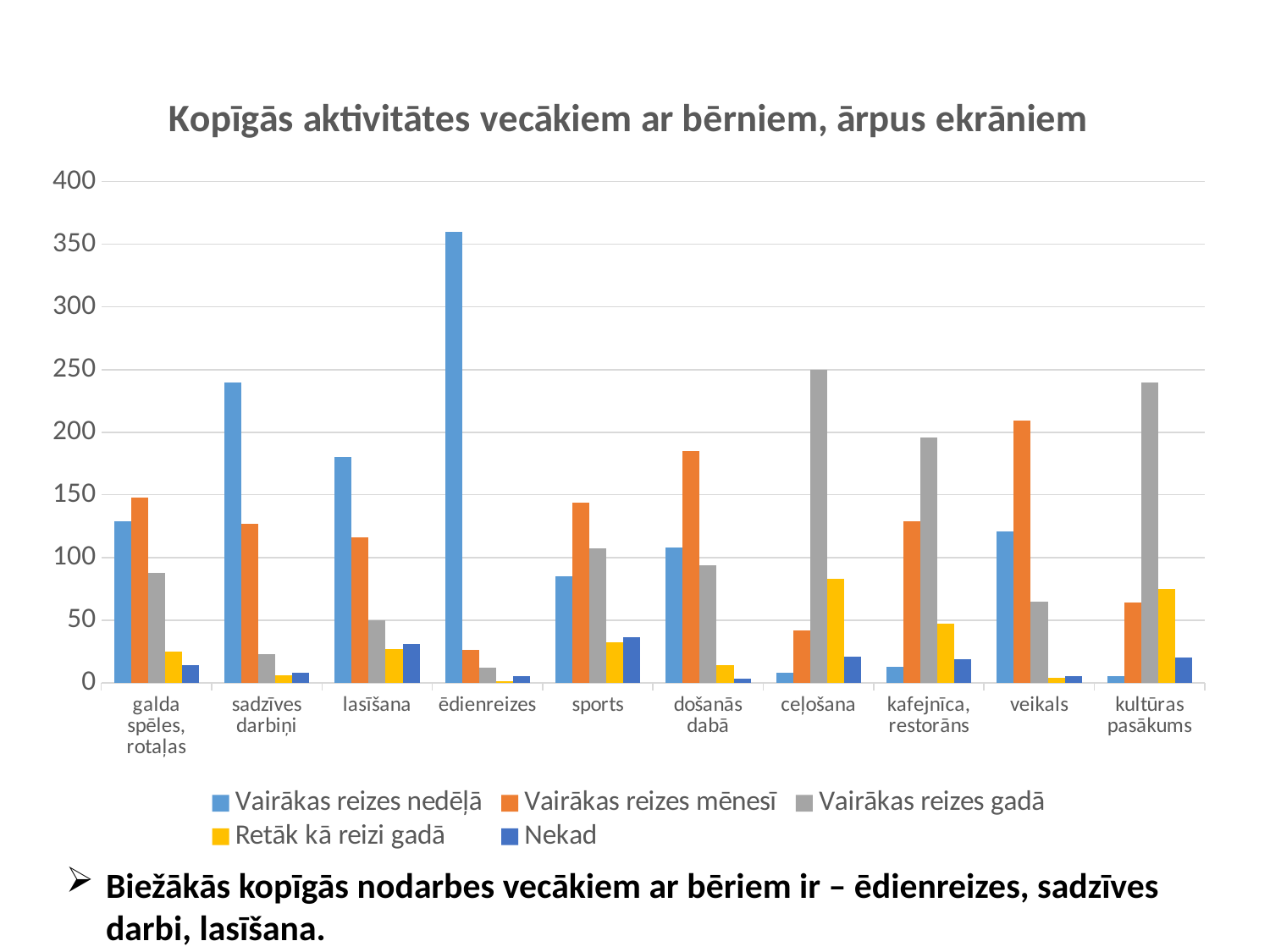
How many series does the legend list? 5 For sports, which is larger: 'Vairākas reizes nedēļā' or 'Vairākas reizes mēnesī'? Vairākas reizes mēnesī What kind of chart is shown on the slide? bar chart Is the 'Vairākas reizes gadā' value for kafejnīca, restorāns greater or less than 150? greater Is the 'Vairākas reizes gadā' value for ceļošana greater or less than 200? greater Which category has the highest value for 'Vairākas reizes nedēļā'? ēdienreizes Which has the larger 'Vairākas reizes nedēļā' value: sadzīves darbiņi or lasīšana? sadzīves darbiņi Which category has the highest value for 'Vairākas reizes mēnesī'? veikals Is the 'Vairākas reizes mēnesī' value for veikals greater or less than 200? greater How many activity categories are shown on the x axis? 10 What is the title of the chart? Kopīgās aktivitātes vecākiem ar bērniem, ārpus ekrāniem